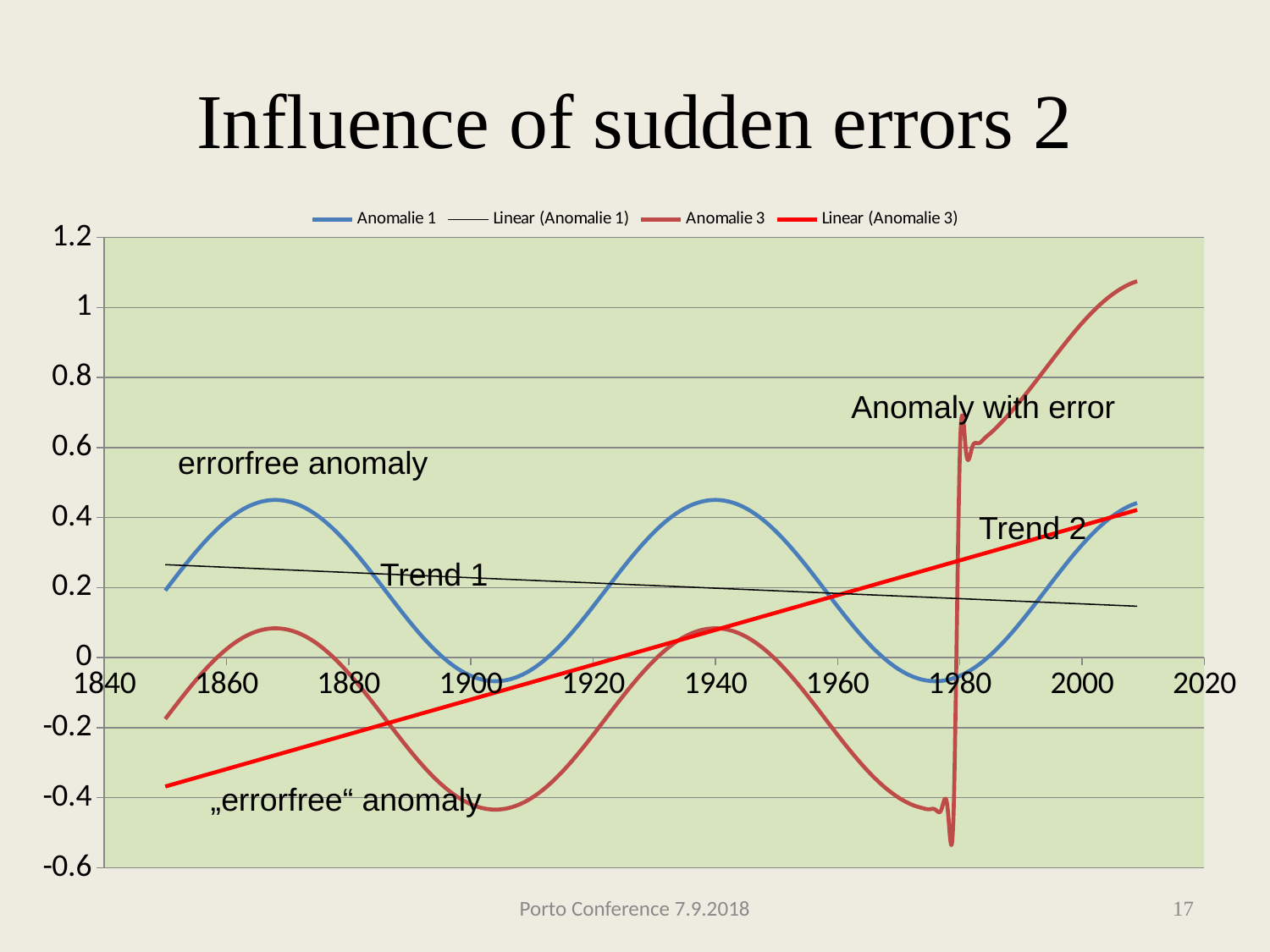
Which series is drawn as a thick red straight line according to the legend? Linear (Anomalie 3) Is the value of Anomalie 3 at 2010 greater or less than 1? greater Is the value of Anomalie 1 at 1940 greater or less than 0.2? greater Does the Linear (Anomalie 3) trend line rise or fall from 1840 to 2020? rise Is the value of Anomalie 3 at 2000 greater or less than 0.8? greater What kind of chart is shown on the slide? line chart How many series does the chart legend list? 4 At 2000, which series has the larger value, Anomalie 1 or Anomalie 3? Anomalie 3 Does the Linear (Anomalie 1) trend line rise or fall from 1840 to 2020? fall Which series reaches the highest value anywhere on the chart? Anomalie 3 What is the title of the slide containing the chart? Influence of sudden errors 2